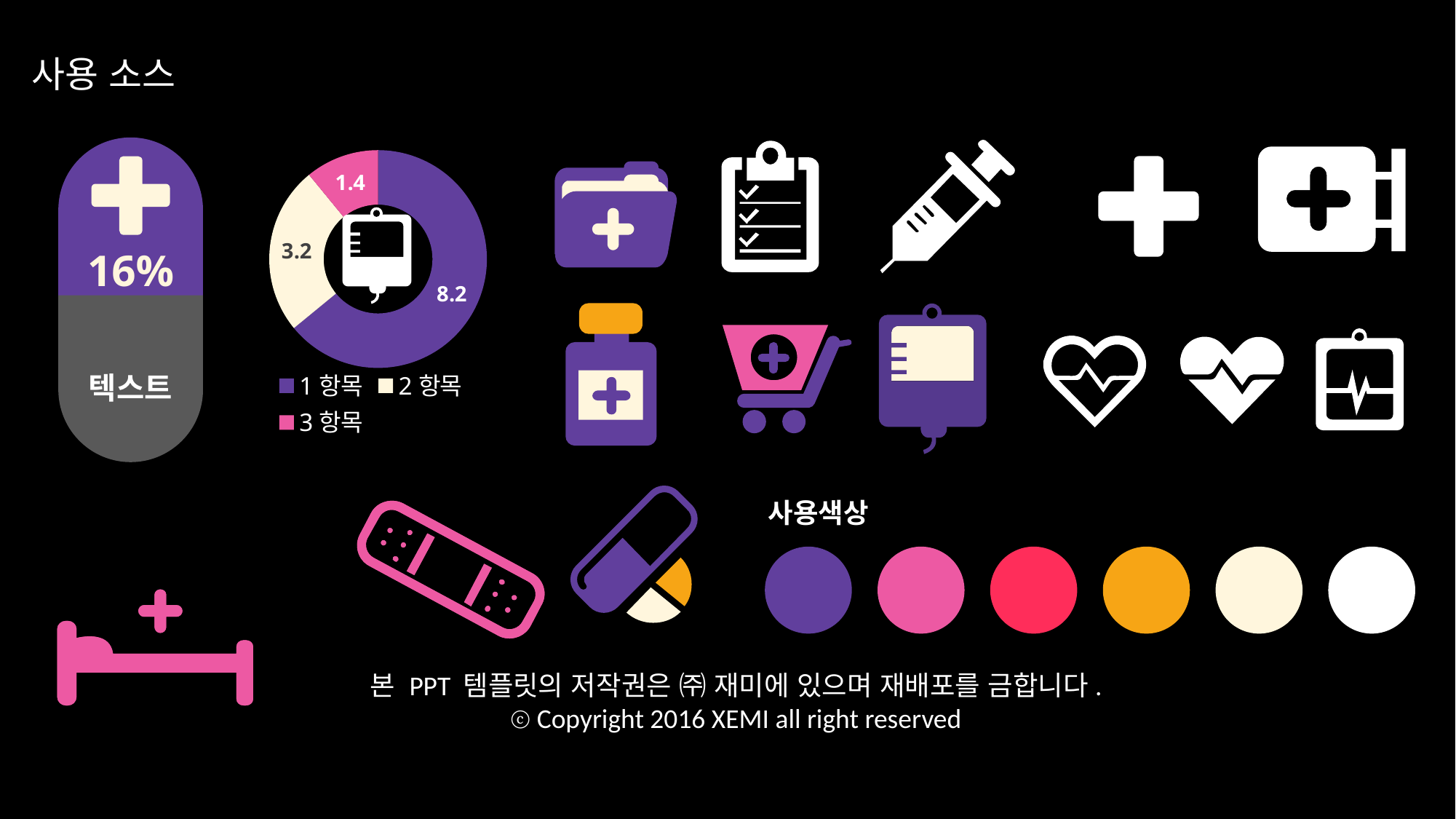
What is the value for 1 항목 in the doughnut chart? 8.2 What is the difference between the values for 1 항목 and 2 항목? 5.0 What share of the doughnut chart does 2 항목 represent? 25% What colour is the slice for 3 항목 in the doughnut chart? Pink What kind of chart is shown on the slide? Doughnut chart Which category has the smallest slice in the doughnut chart? 3 항목 Which is larger, the value for 2 항목 or the value for 3 항목? 2 항목 What is the value for 2 항목 in the doughnut chart? 3.2 Which category has the largest slice in the doughnut chart? 1 항목 What is the value for 3 항목 in the doughnut chart? 1.4 How many slices does the doughnut chart have? 3 What is the difference between the values for 2 항목 and 3 항목? 1.8